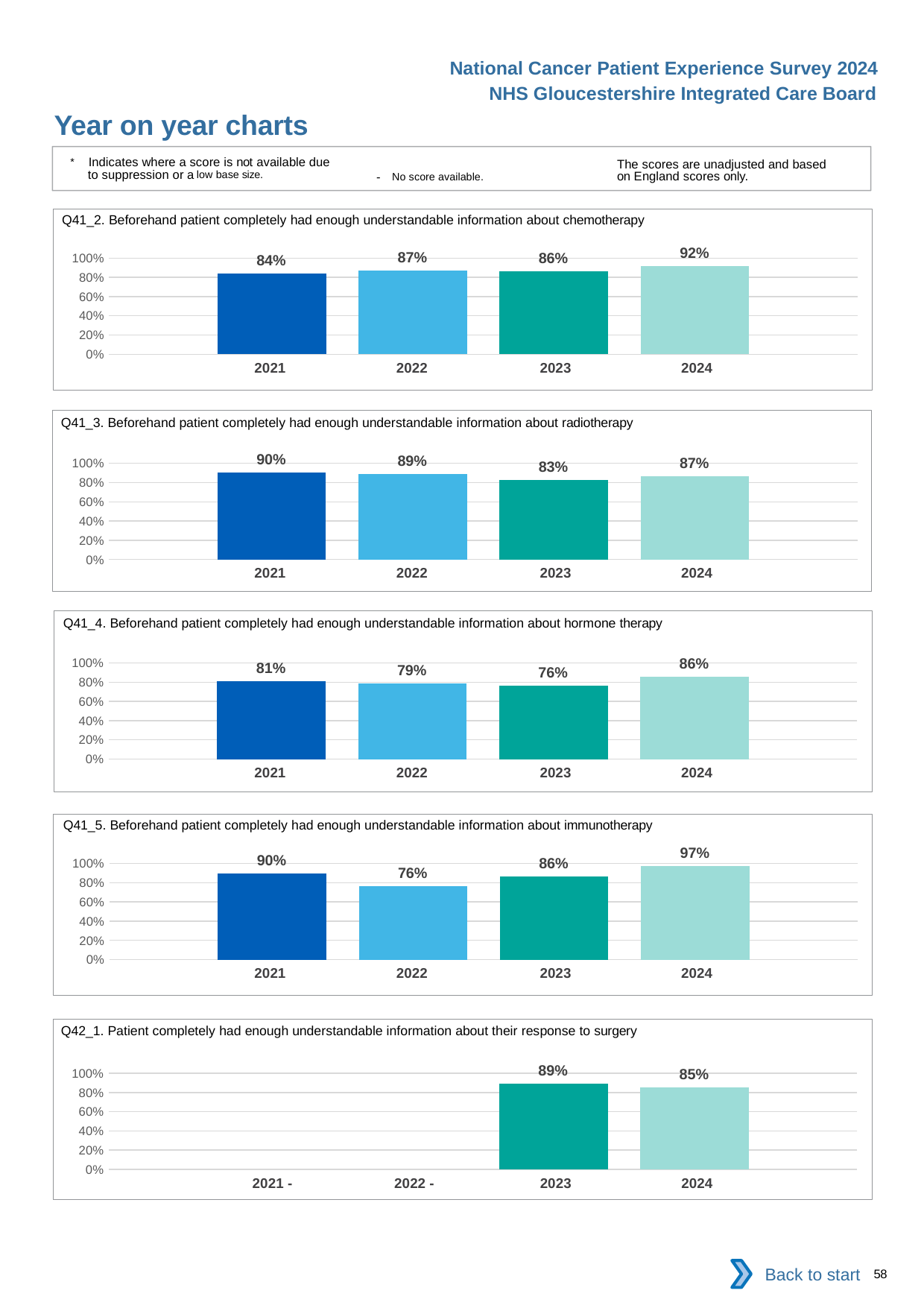
In the Q41_3 radiotherapy chart, which year has the lowest value? 2023 In the Q41_5 immunotherapy chart, what is the value for 2022? 76% In the Q41_2 chemotherapy chart, is the value for 2021 greater or less than 80%? greater In the Q41_4 hormone therapy chart, what is the difference between the 2021 and 2022 values? 2% In the Q41_2 chemotherapy chart, what is the value for 2024? 92% In the Q41_5 immunotherapy chart, which year has the highest value? 2024 In the Q41_4 hormone therapy chart, what is the difference between the 2024 and 2023 values? 10% In the Q42_1 surgery chart, which is larger, the 2023 value or the 2024 value? 2023 How many charts are shown on the slide? 5 In the Q42_1 surgery chart, how many years have a score shown as a bar? 2 In the Q41_3 radiotherapy chart, what is the value for 2021? 90% What type of chart is used for Q41_4 hormone therapy? Bar chart